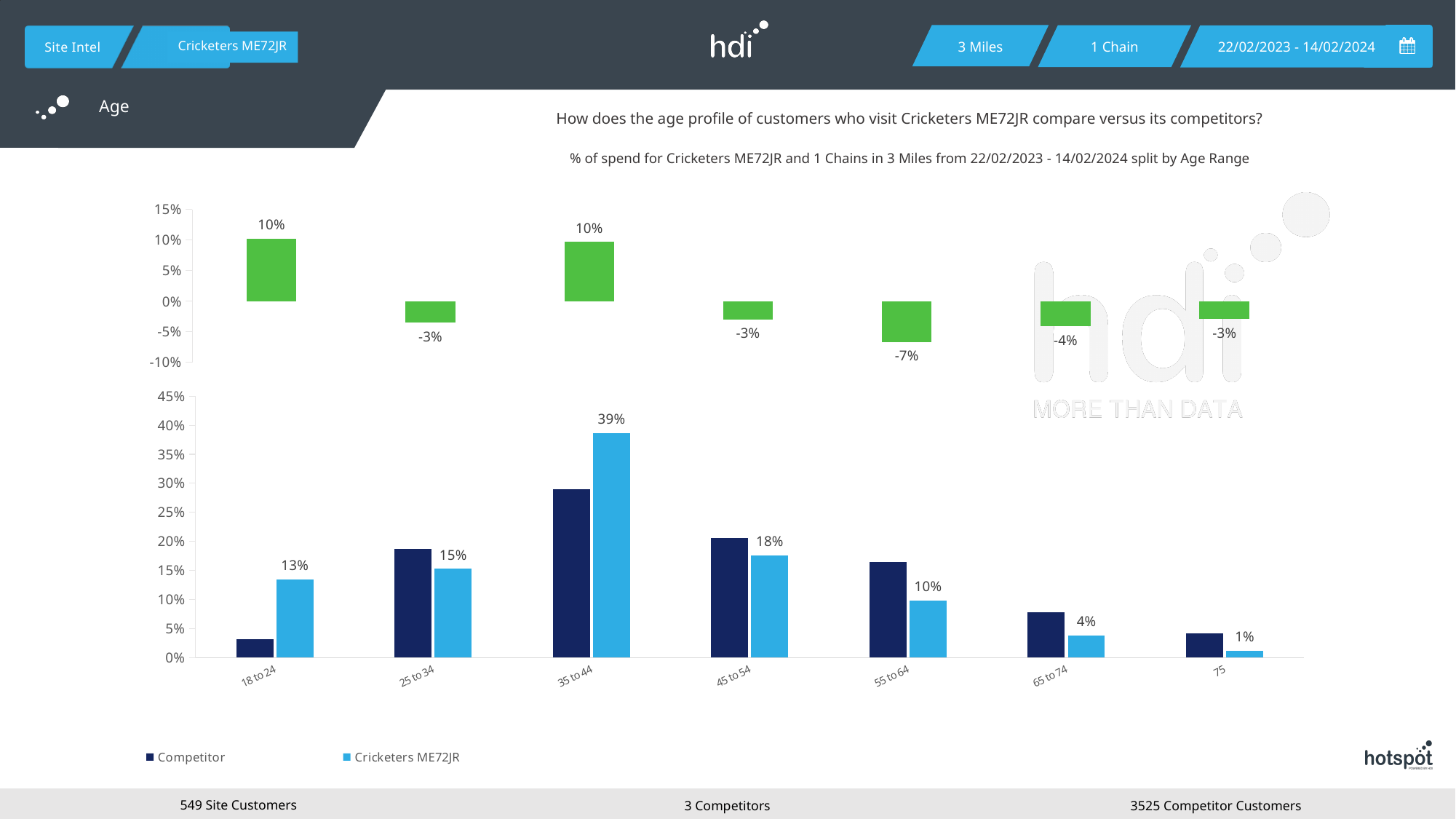
What kind of chart is the bottom chart? bar chart In the bottom chart, what is the value for Cricketers ME72JR in the 35 to 44 age range? 39% In the bottom chart, for the 18 to 24 age range, which series has the larger value, Competitor or Cricketers ME72JR? Cricketers ME72JR In the bottom chart, is the Competitor value for 35 to 44 greater or less than 25%? greater In the bottom chart, which age range has the lowest value for Cricketers ME72JR? 75 How many series does the legend of the bottom chart list? 2 In the bottom chart, which age range has the highest value for Cricketers ME72JR? 35 to 44 In the bottom chart, what is the difference between the Cricketers ME72JR values for 35 to 44 and 25 to 34? 24% In the top chart, which age range has the lowest value? 55 to 64 In the top chart, what is the value of the green bar aligned with the 55 to 64 age range? -7% What are the two series names listed in the legend of the bottom chart? Competitor and Cricketers ME72JR How many age range categories are shown on the x axis of the bottom chart? 7